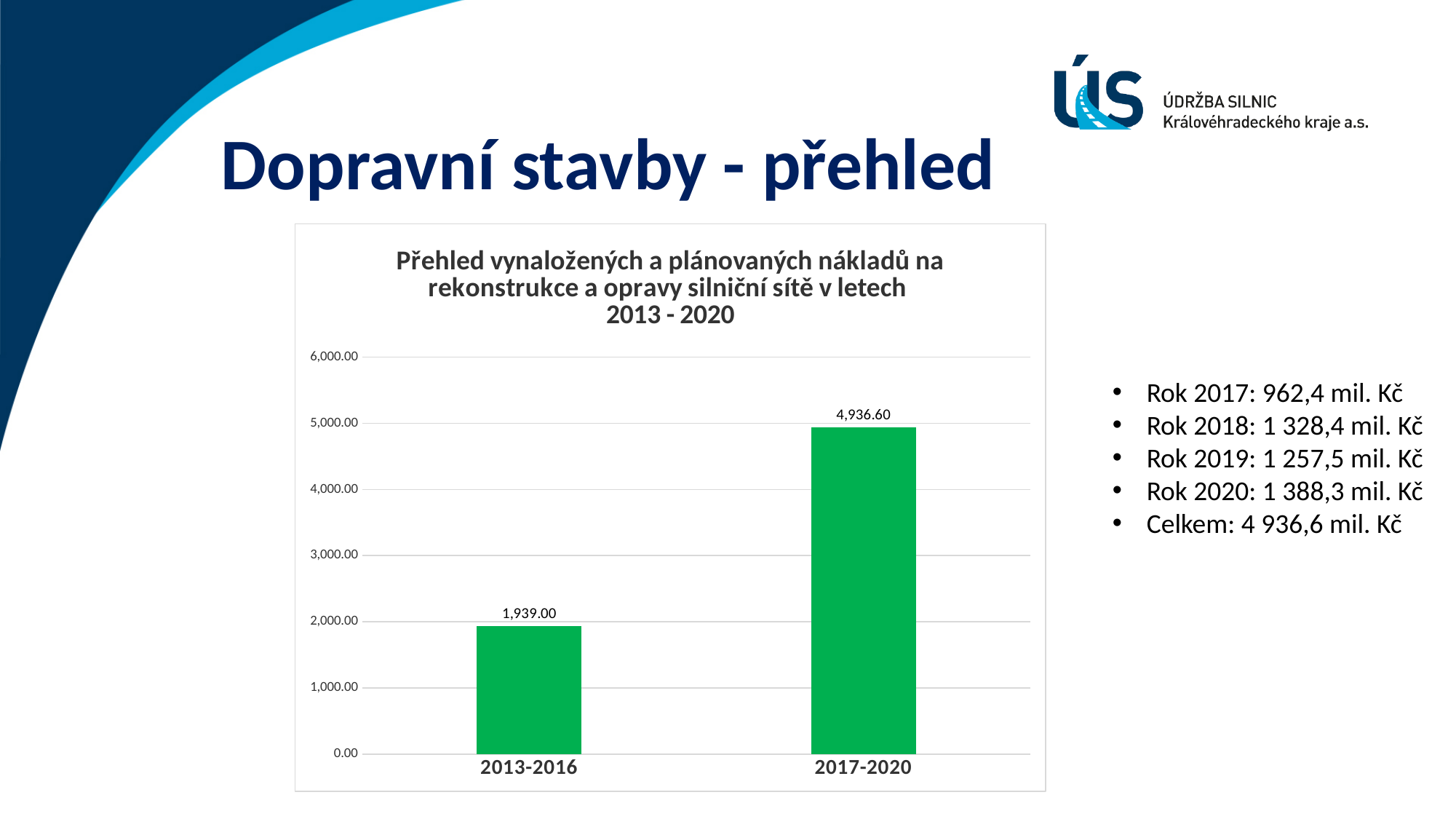
Which period has the highest value? 2017-2020 What is the value for 2017-2020? 4,936.60 What is the value for 2013-2016? 1,939.00 Which period has the lowest value? 2013-2016 Is the value for 2017-2020 greater or less than 5,000.00? less What kind of chart is shown on the slide? bar chart What is the difference between the values for 2017-2020 and 2013-2016? 2,997.60 Is the value for 2013-2016 greater or less than 1,000.00? greater How many categories are shown on the x axis? 2 What colour are the bars in the chart? green Do the values rise or fall from 2013-2016 to 2017-2020? rise Which is larger, the value for 2013-2016 or the value for 2017-2020? 2017-2020